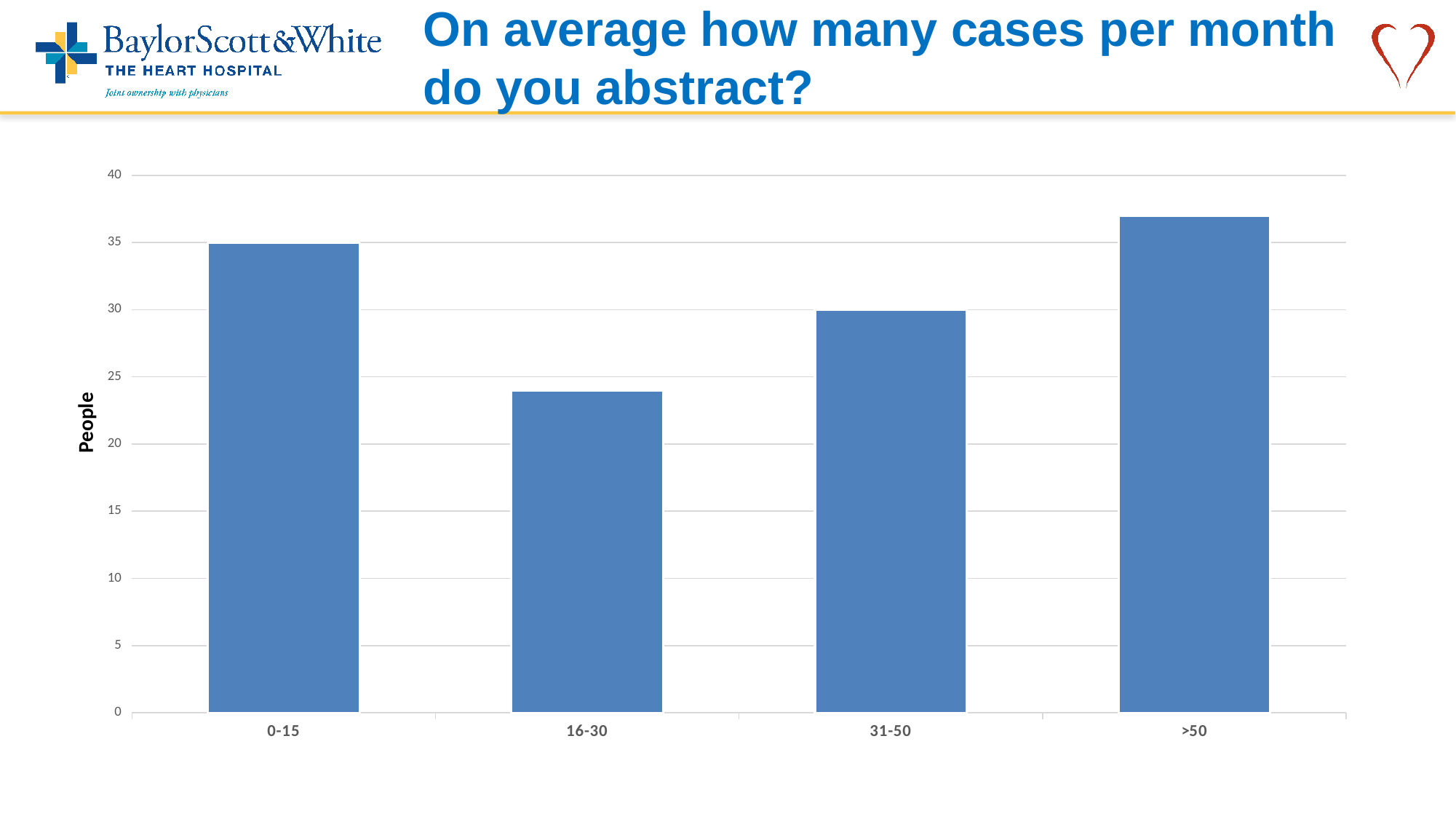
Is the value for >50 greater or less than 35? greater What kind of chart is shown on the slide? bar chart Which is larger, the value for 16-30 or the value for >50? >50 What is the label on the y axis of the chart? People Is the value for 16-30 greater or less than 25? less Is the value for 0-15 greater or less than 30? greater Which category has the lowest bar? 16-30 How many categories are shown on the x axis of the chart? 4 What is the title of the slide containing the chart? On average how many cases per month do you abstract? Which category has the highest bar? >50 Which is larger, the value for 0-15 or the value for 31-50? 0-15